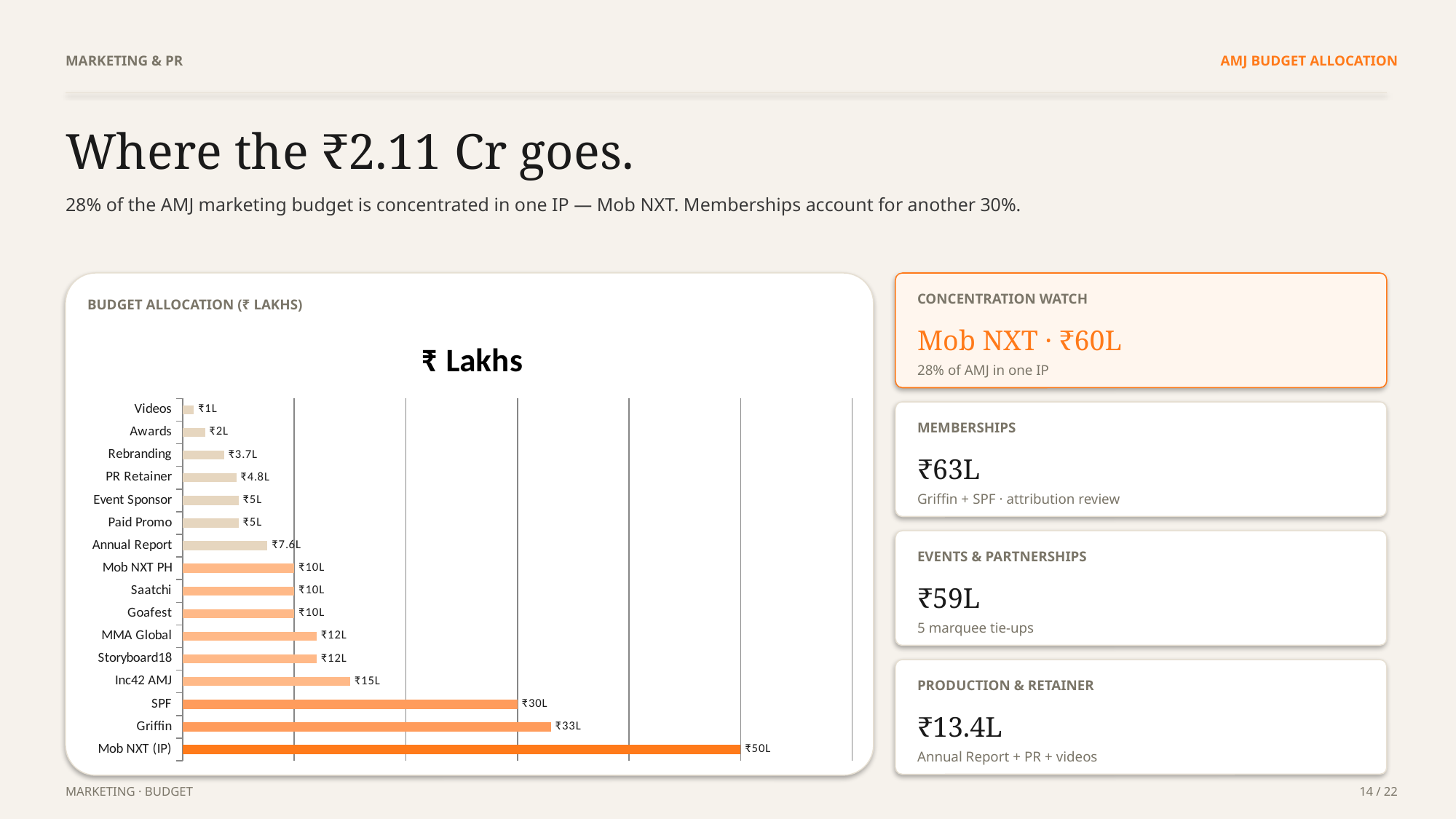
What is the difference between the values for SPF and Inc42 AMJ? ₹15L What is the value for Rebranding in the chart? ₹3.7L What is the title of the chart? ₹ Lakhs Which is larger, the value for PR Retainer or the value for Awards? PR Retainer What kind of chart is shown on the slide? Bar chart What is the difference between the values for Mob NXT (IP) and Griffin? ₹17L What is the value for Annual Report in the chart? ₹7.6L How many categories are shown in the chart? 16 What is the value for Griffin in the chart? ₹33L Which category has the lowest value in the chart? Videos Which category has the highest value in the chart? Mob NXT (IP) What is the value for Inc42 AMJ in the chart? ₹15L